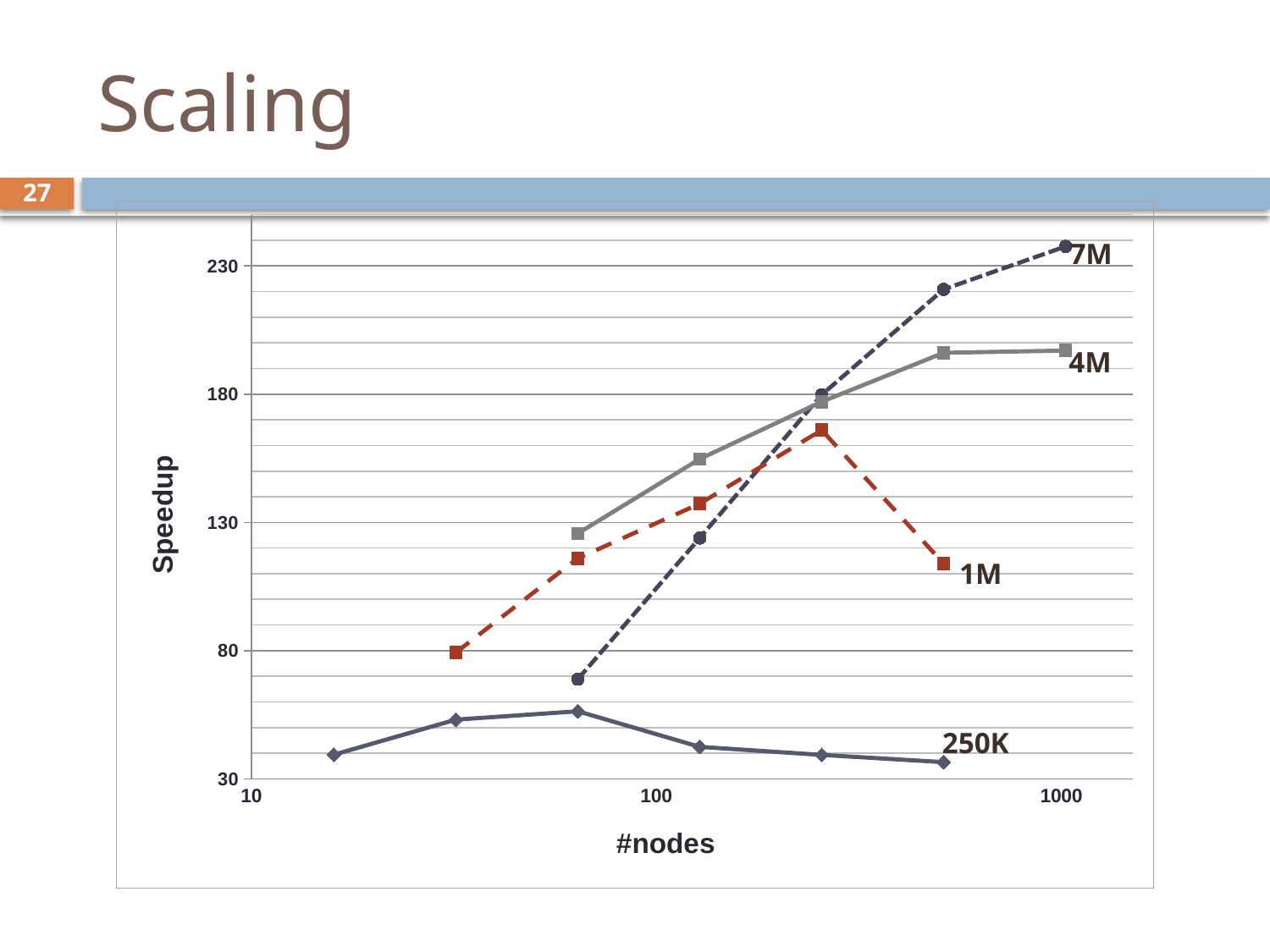
Which series reaches the highest speedup on the chart? 7M What kind of chart is shown on the slide? line chart How many data points are plotted for the 250K series? 6 Is the speedup of the 4M series at its rightmost point greater or less than 180? greater Does the speedup of the 7M series rise or fall as #nodes increases? rises Is the speedup of the 1M series at its rightmost point greater or less than 130? less What is the label of the x axis? #nodes Which series has the lowest speedup values on the chart? 250K Is the speedup of the 7M series at its rightmost point (about 1000 nodes) greater or less than 230? greater At about 500 nodes, which series has the higher speedup, 7M or 4M? 7M How many data series are plotted on the chart? 4